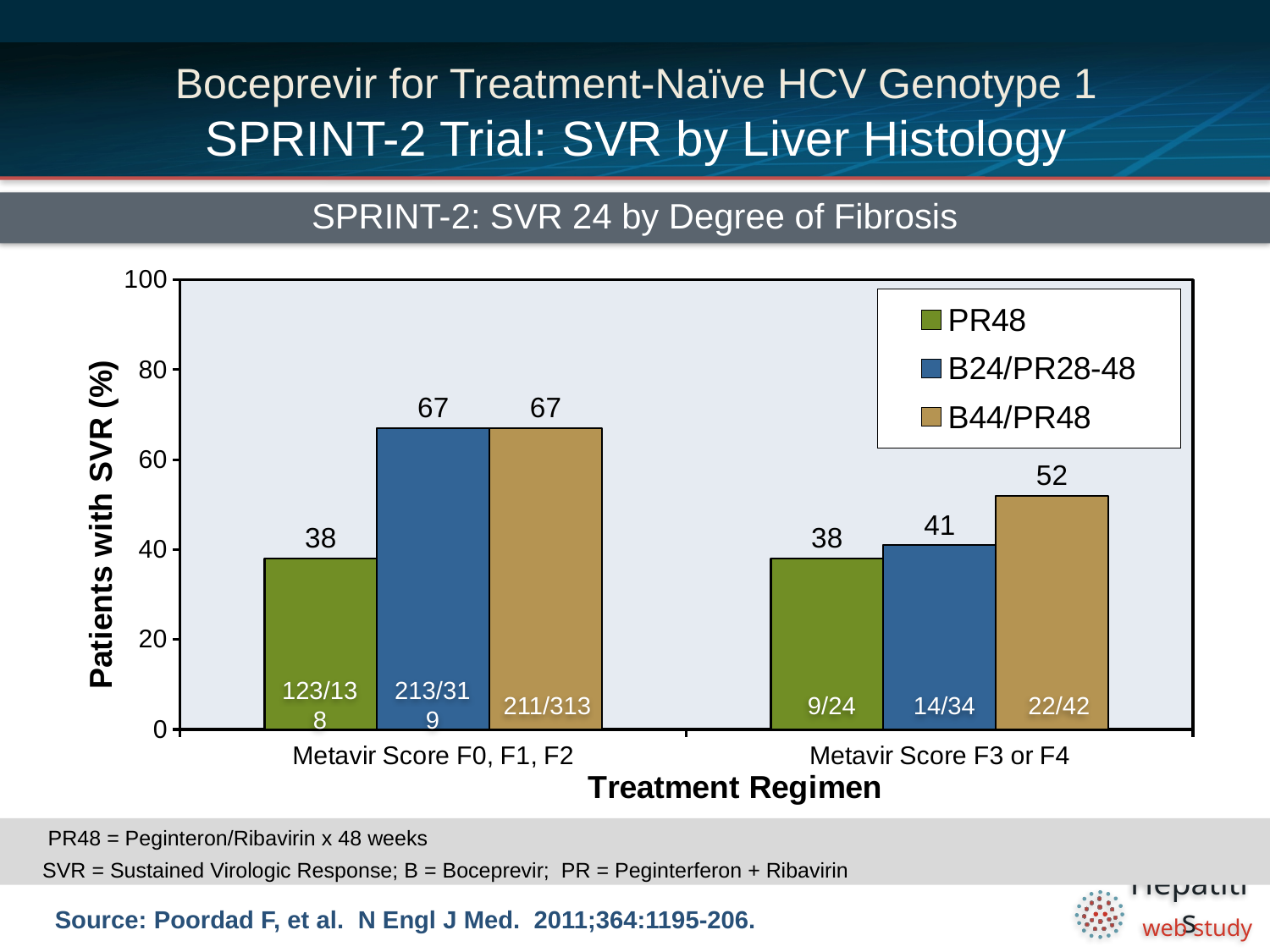
How many treatment regimens does the legend list? 3 What is the SVR rate for the PR48 group among patients with Metavir Score F0, F1, F2? 38 What kind of chart is shown on the slide? Bar chart What is the SVR rate for the B24/PR28-48 group among patients with Metavir Score F3 or F4? 41 Which treatment regimen has the lowest SVR rate among patients with Metavir Score F0, F1, F2? PR48 What is the difference in SVR rate between the B44/PR48 group and the PR48 group among patients with Metavir Score F3 or F4? 14 What is the SVR rate for the B44/PR48 group among patients with Metavir Score F3 or F4? 52 How many Metavir score categories are shown on the x axis? 2 Which treatment regimen has the highest SVR rate among patients with Metavir Score F3 or F4? B44/PR48 What is the difference in SVR rate between the B24/PR28-48 group and the PR48 group among patients with Metavir Score F0, F1, F2? 29 Is the SVR rate for the B44/PR48 group higher among patients with Metavir Score F0, F1, F2 or among patients with Metavir Score F3 or F4? Metavir Score F0, F1, F2 What is the label of the y axis? Patients with SVR (%)